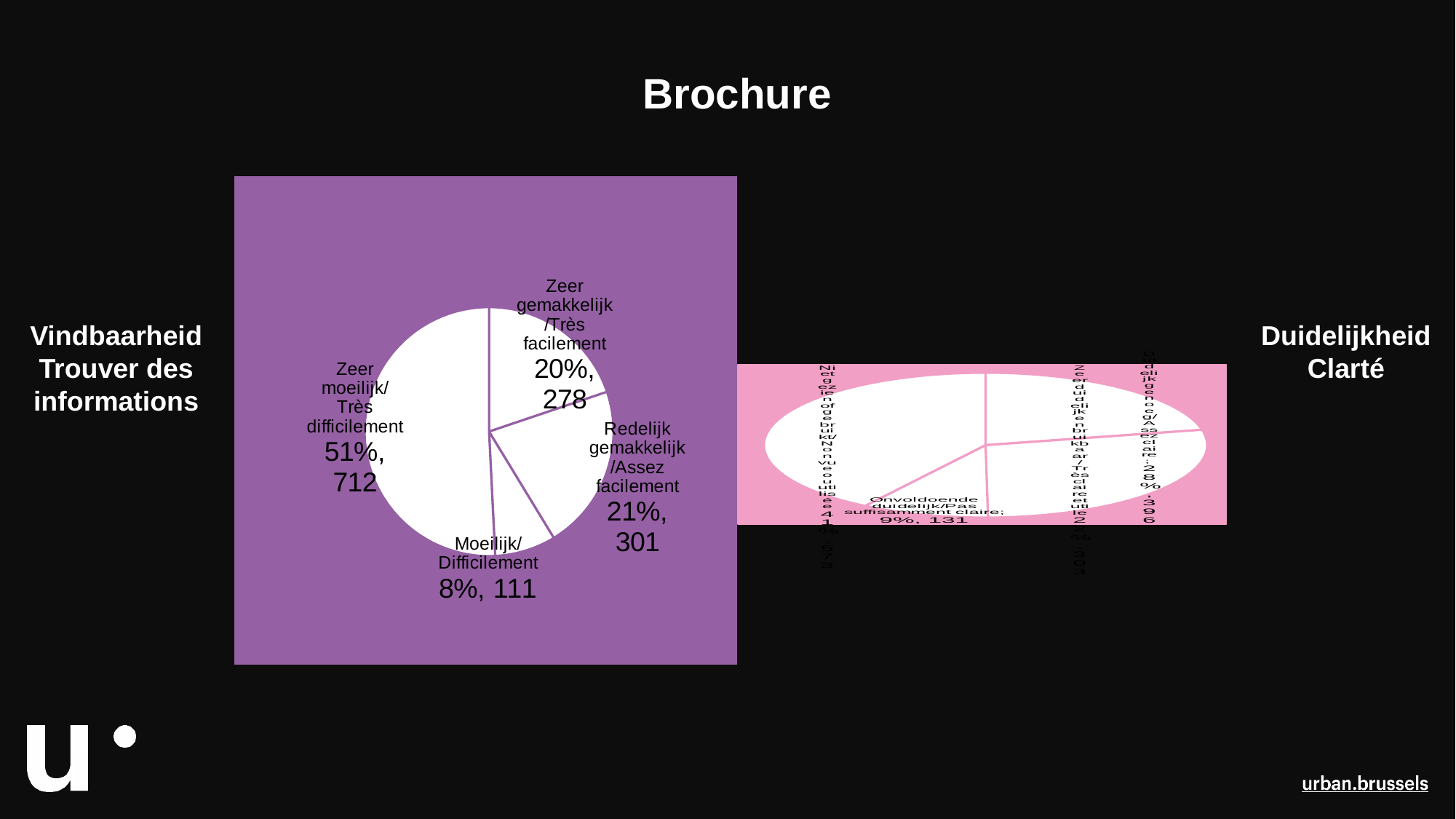
On the right pie chart (Duidelijkheid / Clarté), what percentage and count are shown for 'Onvoldoende duidelijk/Pas suffisamment claire'? 9%, 131 On the left pie chart (Vindbaarheid / Trouver des informations), what count is shown for 'Zeer gemakkelijk/Très facilement'? 278 On the left pie chart (Vindbaarheid / Trouver des informations), which has a larger count: 'Redelijk gemakkelijk/Assez facilement' or 'Moeilijk/Difficilement'? Redelijk gemakkelijk/Assez facilement On the left pie chart (Vindbaarheid / Trouver des informations), what count is shown for 'Redelijk gemakkelijk/Assez facilement'? 301 On the left pie chart (Vindbaarheid / Trouver des informations), which category has the smallest slice? Moeilijk/Difficilement On the left pie chart (Vindbaarheid / Trouver des informations), what percentage is shown for 'Zeer moeilijk/Très difficilement'? 51% How many slices does the left pie chart (Vindbaarheid / Trouver des informations) have? 4 What type of chart is used for 'Vindbaarheid / Trouver des informations' on the left? Pie chart On the left pie chart (Vindbaarheid / Trouver des informations), what percentage and count are shown for 'Moeilijk/Difficilement'? 8%, 111 On the left pie chart (Vindbaarheid / Trouver des informations), what is the difference in count between 'Zeer moeilijk/Très difficilement' and 'Zeer gemakkelijk/Très facilement'? 434 What is the title at the top of the slide? Brochure On the left pie chart (Vindbaarheid / Trouver des informations), which category has the largest slice? Zeer moeilijk/Très difficilement